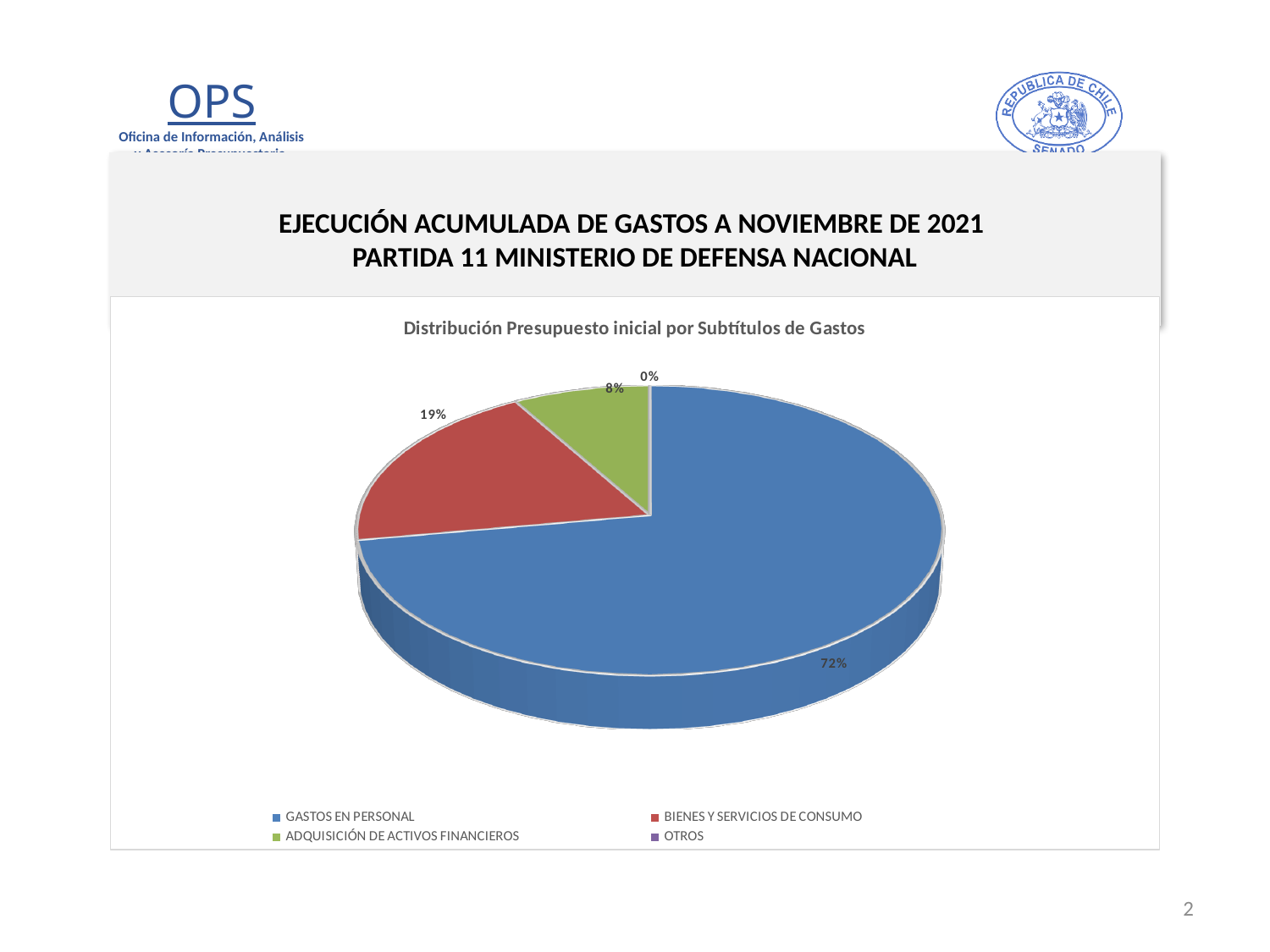
How many categories does the legend list? 4 What share of the pie does ADQUISICIÓN DE ACTIVOS FINANCIEROS represent? 8% Which category has the smallest slice of the pie? OTROS Which is larger, the share for BIENES Y SERVICIOS DE CONSUMO or the share for ADQUISICIÓN DE ACTIVOS FINANCIEROS? BIENES Y SERVICIOS DE CONSUMO What share of the pie does GASTOS EN PERSONAL represent? 72% What is the title of the chart? Distribución Presupuesto inicial por Subtítulos de Gastos What kind of chart is shown on the slide? Pie chart What colour is the slice for BIENES Y SERVICIOS DE CONSUMO? Red Which category has the largest slice of the pie? GASTOS EN PERSONAL What share of the pie does BIENES Y SERVICIOS DE CONSUMO represent? 19% What is the difference in percentage points between GASTOS EN PERSONAL and BIENES Y SERVICIOS DE CONSUMO? 53 percentage points